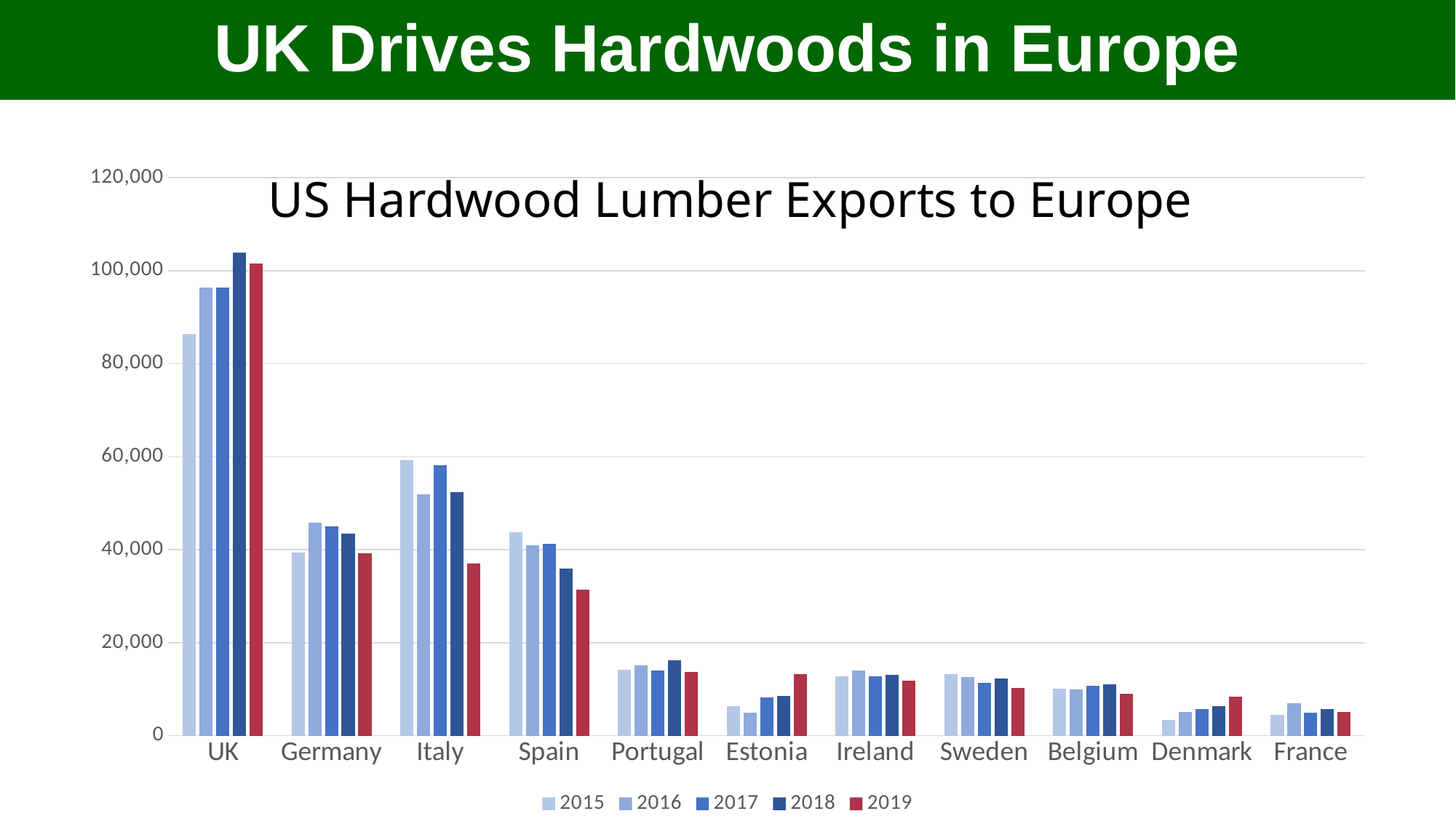
Which country has the highest value for 2018? UK How many countries are shown on the x axis of the chart? 11 Which is larger for Estonia, the 2015 value or the 2019 value? 2019 How many series does the legend list? 5 Is the value for Spain in 2019 greater or less than 40,000? less What is the title of the chart? US Hardwood Lumber Exports to Europe What kind of chart is shown on the slide? bar chart Is the value for Portugal in 2018 greater or less than 20,000? less Which country has the lowest value for 2015? Denmark Which is larger, the 2015 value for Italy or the 2015 value for Spain? Italy Is the value for UK in 2018 greater or less than 100,000? greater